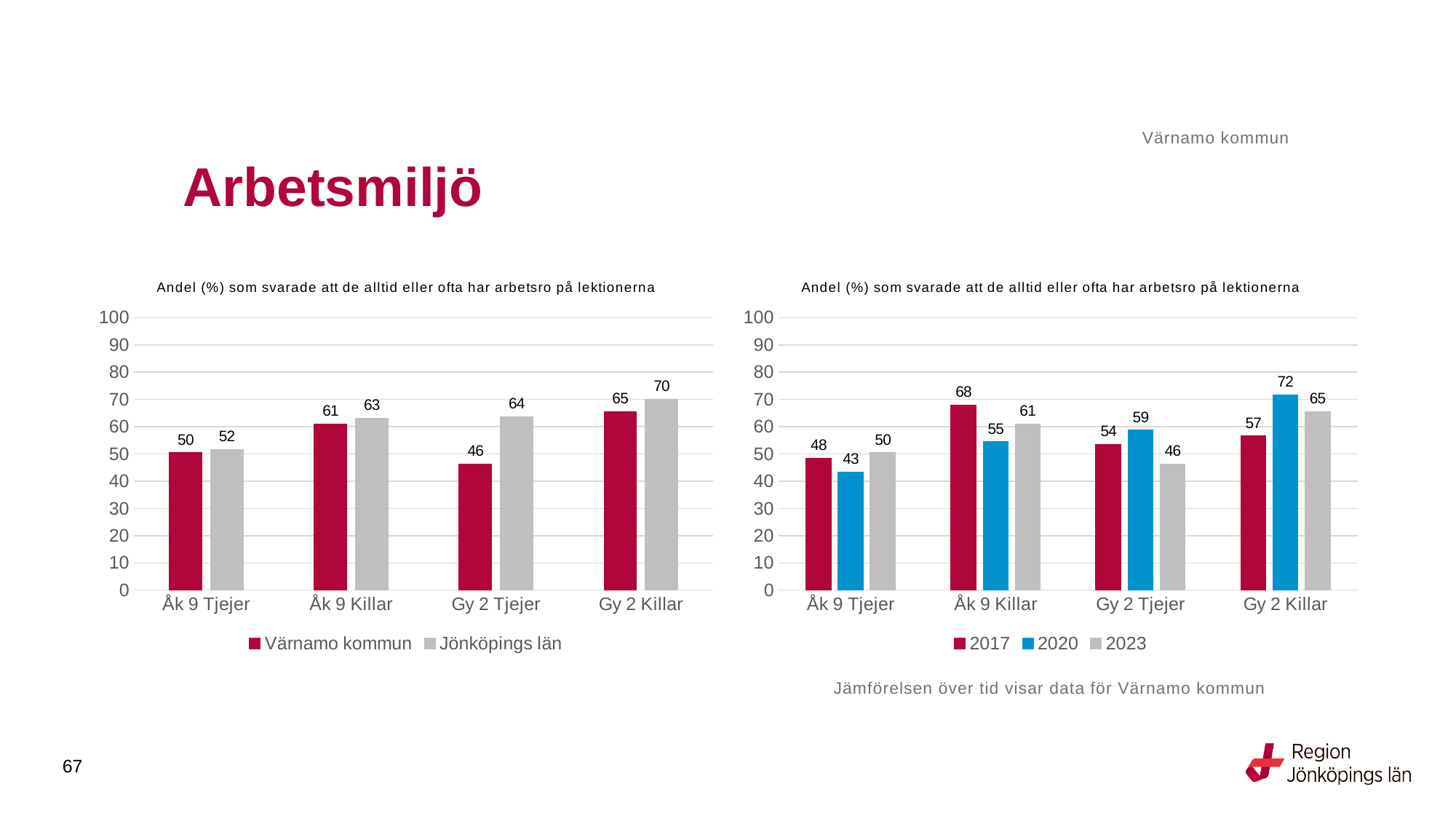
In the right chart, what is the difference between 2020 and 2023 for Gy 2 Killar? 7 In the left chart, what is the value for Jönköpings län for Gy 2 Killar? 70 In the left chart, what is the difference between Jönköpings län and Värnamo kommun for Gy 2 Tjejer? 18 What kind of chart is the right chart? Bar chart In the left chart, how many series does the legend list? 2 In the right chart, which is larger for Gy 2 Tjejer: 2017 or 2023? 2017 In the right chart, what is the value for 2017 for Åk 9 Killar? 68 In the right chart, which category has the highest value for 2020? Gy 2 Killar In the right chart, which category has the lowest value for 2023? Gy 2 Tjejer In the left chart, which category has the highest value for Värnamo kommun? Gy 2 Killar In the left chart, what is the value for Värnamo kommun for Gy 2 Tjejer? 46 In the right chart, what is the value for 2020 for Åk 9 Tjejer? 43